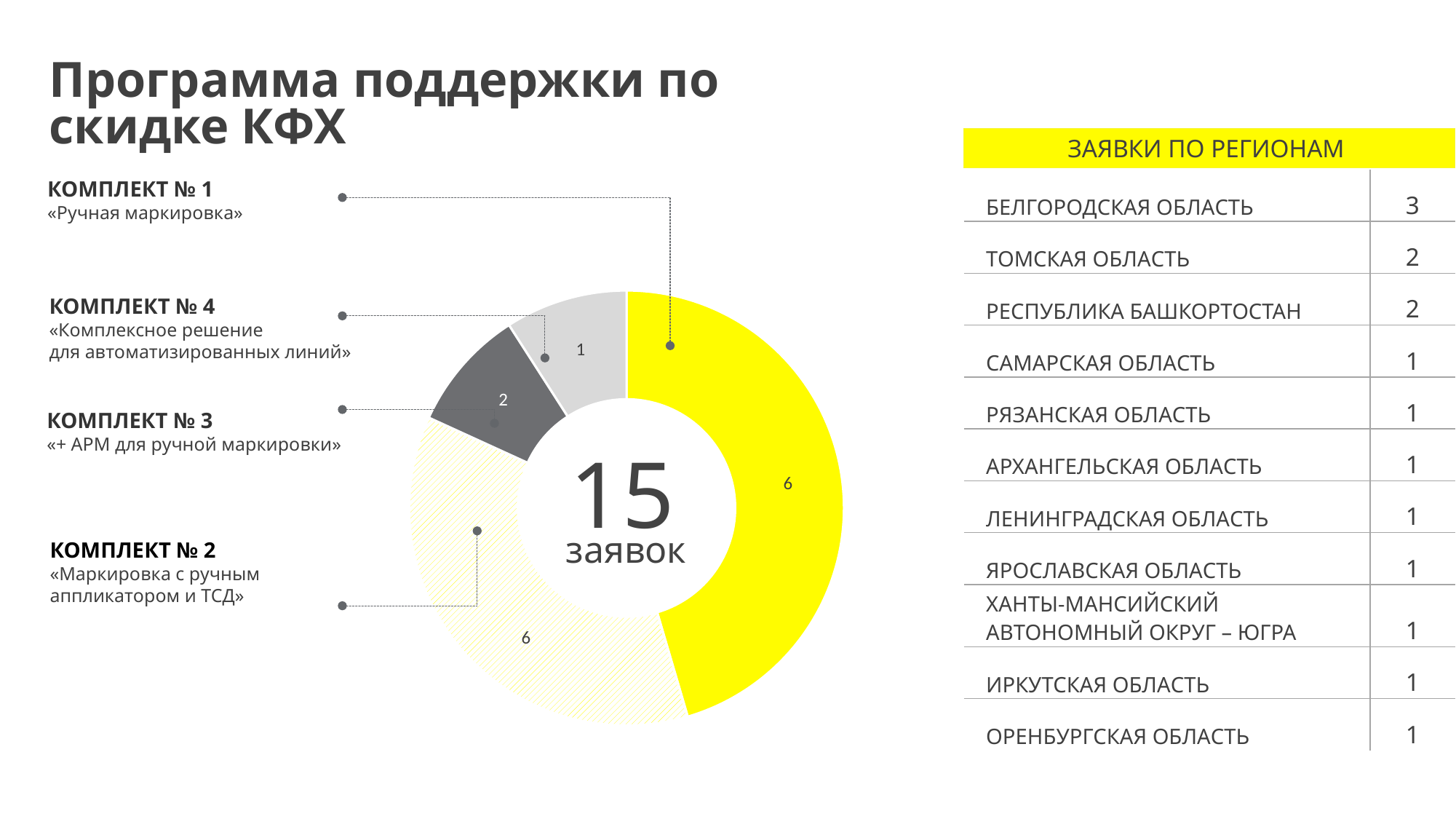
What is the difference between the values for Комплект № 1 and Комплект № 3 in the donut chart? 4 What kind of chart is shown on the slide? Donut (pie) chart What is the value for Комплект № 1 «Ручная маркировка» in the donut chart? 6 What share of the 15 заявок does Комплект № 1 account for in the donut chart? 40% Which комплект has the smallest slice in the donut chart? Комплект № 4 What is the value for Комплект № 2 «Маркировка с ручным аппликатором и ТСД» in the donut chart? 6 What colour is the slice for Комплект № 1 in the donut chart? Yellow How many slices does the donut chart have? 4 What is the value for Комплект № 4 «Комплексное решение для автоматизированных линий» in the donut chart? 1 Which is larger in the donut chart: the value for Комплект № 3 or Комплект № 4? Комплект № 3 What is the value for Комплект № 3 «+ АРМ для ручной маркировки» in the donut chart? 2 What total number of заявок is shown in the centre of the donut chart? 15 заявок